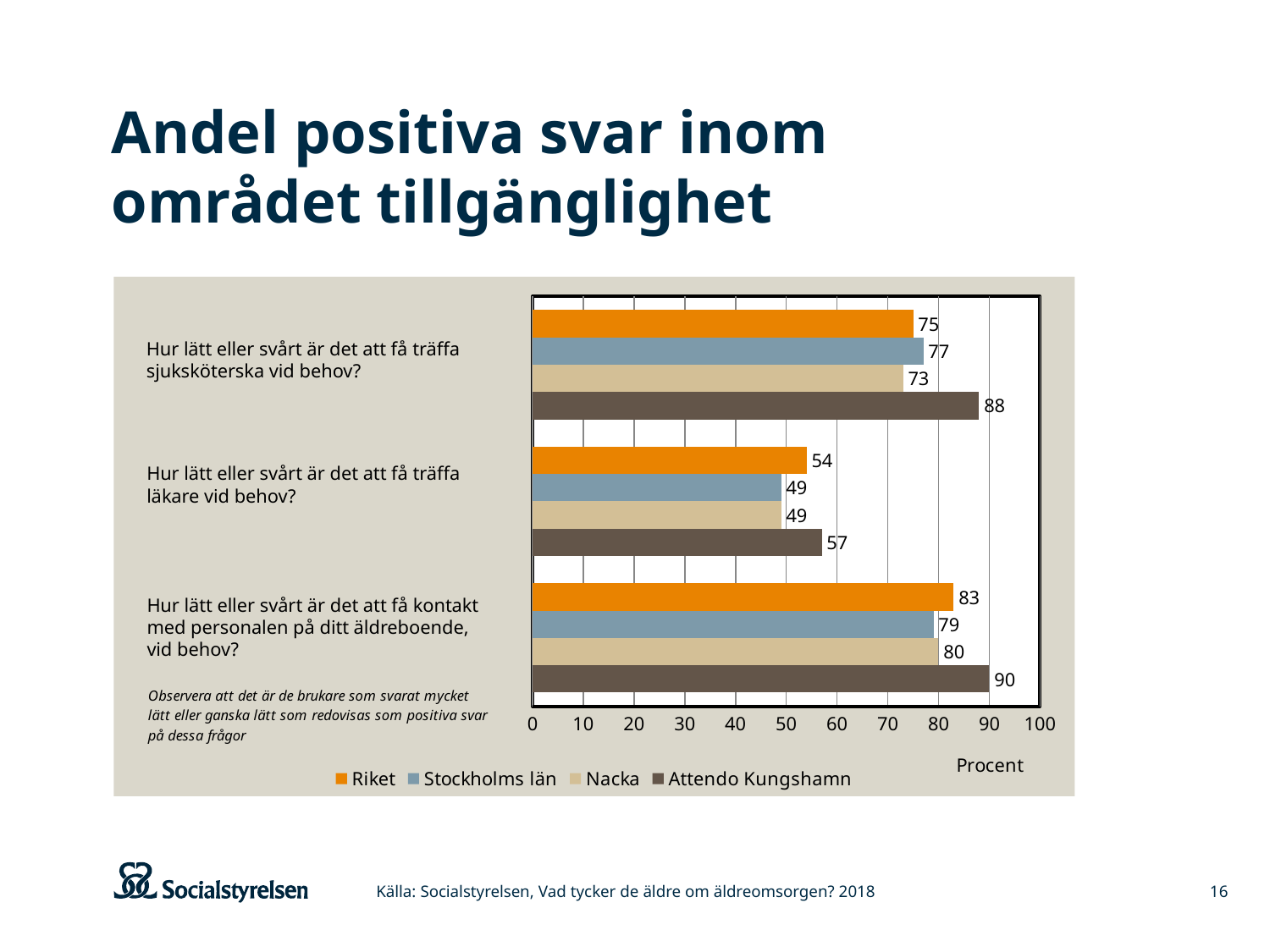
Is the value for Stockholms län on the question "Hur lätt eller svårt är det att få träffa läkare vid behov?" greater or less than 50? less Which is larger on the question "Hur lätt eller svårt är det att få träffa läkare vid behov?": Riket or Attendo Kungshamn? Attendo Kungshamn What is the value for Attendo Kungshamn on the question "Hur lätt eller svårt är det att få träffa sjuksköterska vid behov?"? 88 What is the difference between Attendo Kungshamn and Riket on the question "Hur lätt eller svårt är det att få träffa sjuksköterska vid behov?"? 13 How many series does the legend list? 4 Which series has the lowest value on the question "Hur lätt eller svårt är det att få träffa sjuksköterska vid behov?"? Nacka Which series has the highest value on the question "Hur lätt eller svårt är det att få kontakt med personalen på ditt äldreboende, vid behov?"? Attendo Kungshamn What unit is shown on the horizontal axis of the chart? Procent What kind of chart is shown on the slide? bar chart What is the value for Nacka on the question "Hur lätt eller svårt är det att få kontakt med personalen på ditt äldreboende, vid behov?"? 80 What is the value for Riket on the question "Hur lätt eller svårt är det att få träffa läkare vid behov?"? 54 How many questions (categories) are shown in the chart? 3